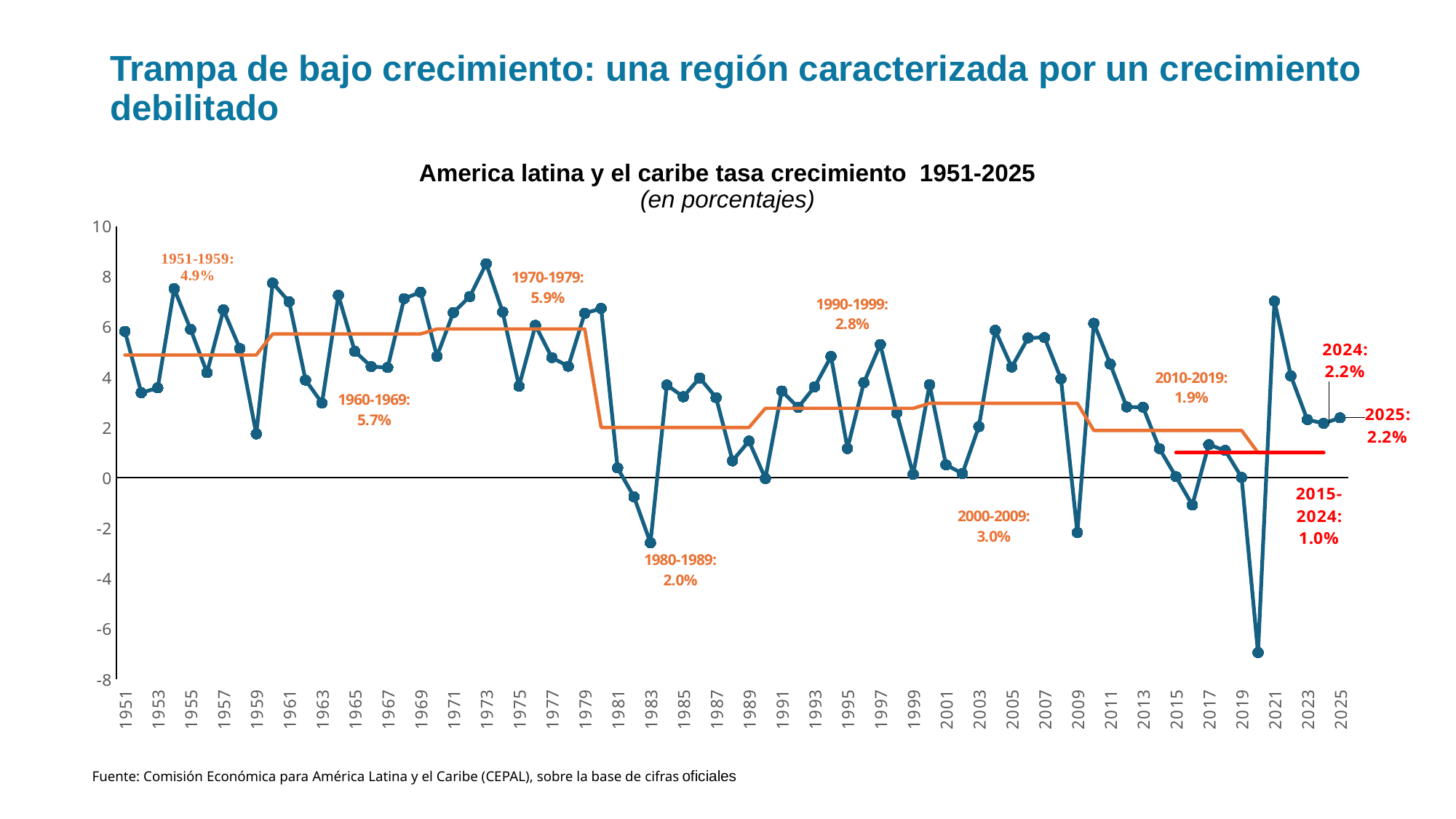
What is the average growth rate shown for 1980-1989? 2.0% What is the average growth rate shown for 2015-2024? 1.0% Is the value for 1973 greater or less than 8? greater Is the value for 2020 greater or less than -6? less Which is larger, the 1960-1969 average or the 1990-1999 average? 1960-1969 What is the difference between the 1970-1979 average (5.9%) and the 2010-2019 average (1.9%)? 4.0 percentage points In which year does the line reach its lowest point? 2020 What growth rate is shown for 2025? 2.2% What kind of chart is shown on the slide? Line chart What is the average growth rate shown for 1951-1959? 4.9% Which decade has the highest average growth rate annotated on the chart? 1970-1979